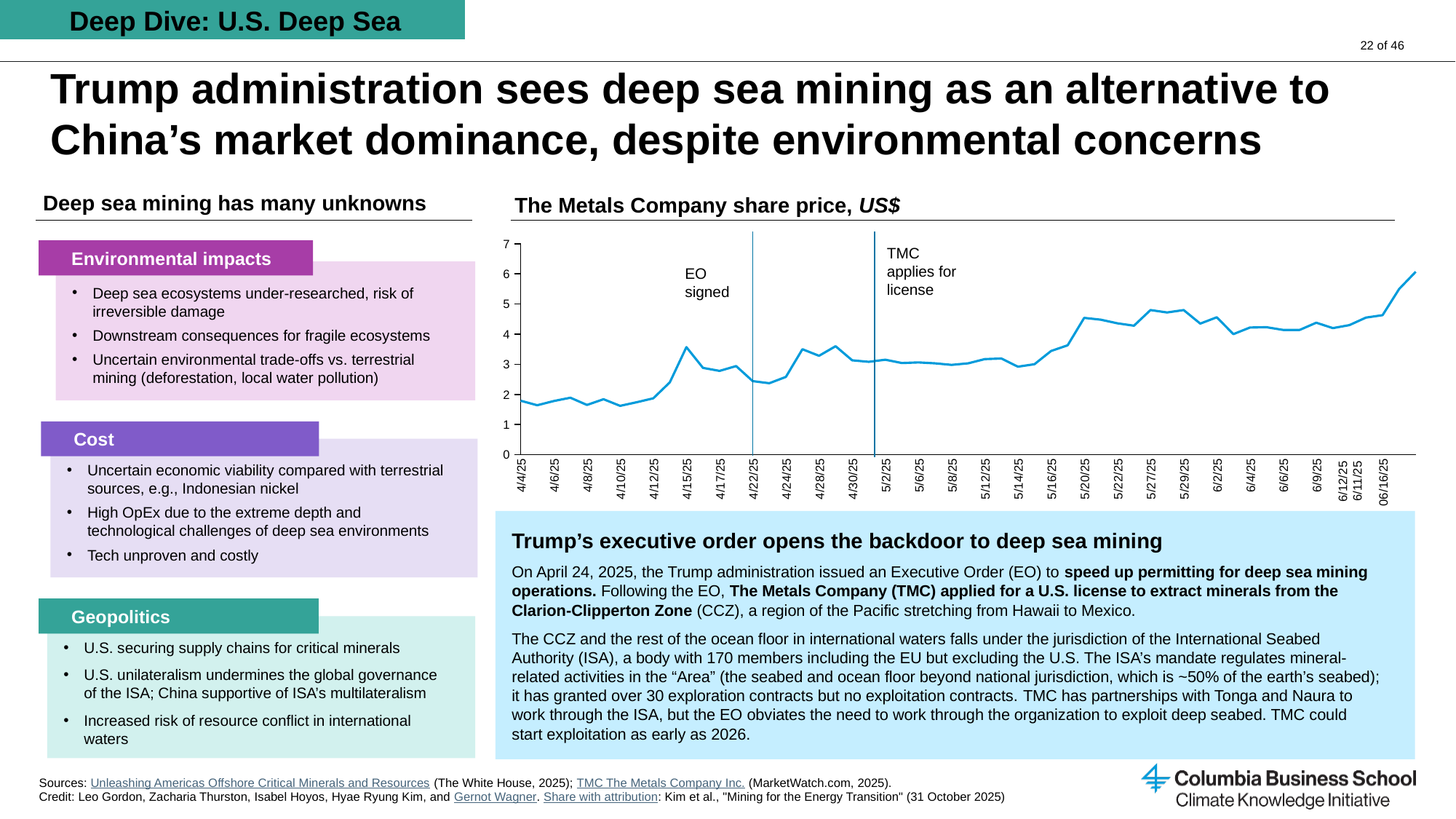
In the share price chart, which date has the highest share price? 06/16/25 In the share price chart, is the value for 4/4/25 greater or less than 2? less In the share price chart, does the share price generally rise or fall from 4/4/25 to 06/16/25? rise What is the title of the chart on the right side of the slide? The Metals Company share price, US$ In the share price chart, is the value for 5/20/25 greater or less than 4? greater In the share price chart, what event is marked by the first vertical line? EO signed In the share price chart, is the value for 4/15/25 greater or less than 3? greater In the share price chart, is the share price higher on 06/16/25 or on 4/4/25? 06/16/25 In the share price chart, what is the highest value shown on the y axis? 7 What kind of chart is used to show The Metals Company share price? line chart